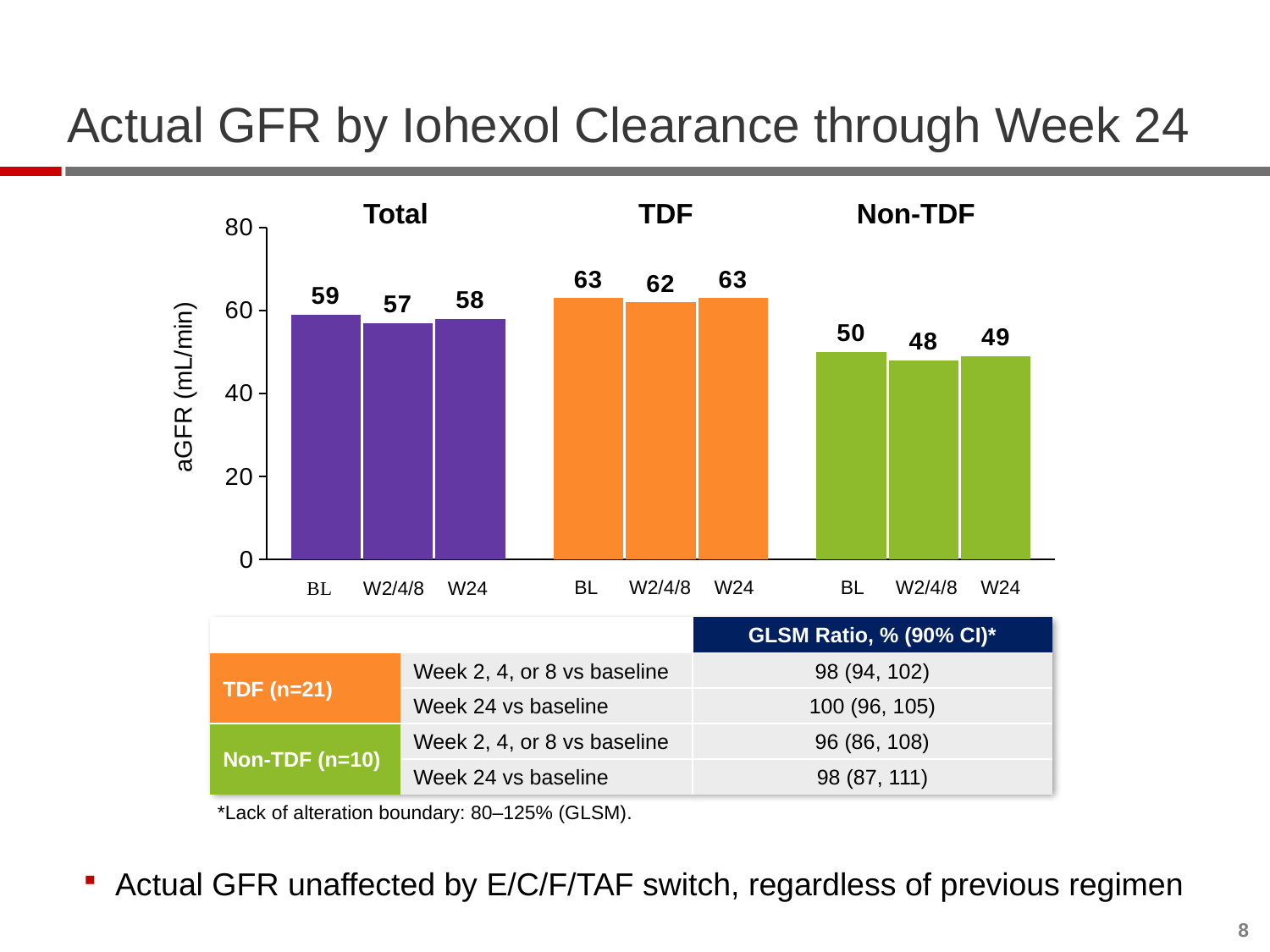
What colour are the bars for the TDF group? orange What type of chart is shown on the slide? bar chart Which group has the highest aGFR value at baseline (BL)? TDF What is the maximum value shown on the y-axis of the chart? 80 What is the aGFR value at W24 for the TDF group? 63 What is the difference between the TDF baseline value and the Non-TDF baseline value? 13 What is the aGFR value at baseline (BL) for the Total group? 59 How many bars are plotted in the chart in total? 9 What is the aGFR value at W2/4/8 for the Non-TDF group? 48 Is the aGFR value at W24 for the Total group larger or smaller than the W24 value for the Non-TDF group? larger Which bar shows the lowest aGFR value on the chart? Non-TDF W2/4/8 What is the label of the y-axis of the chart? aGFR (mL/min)